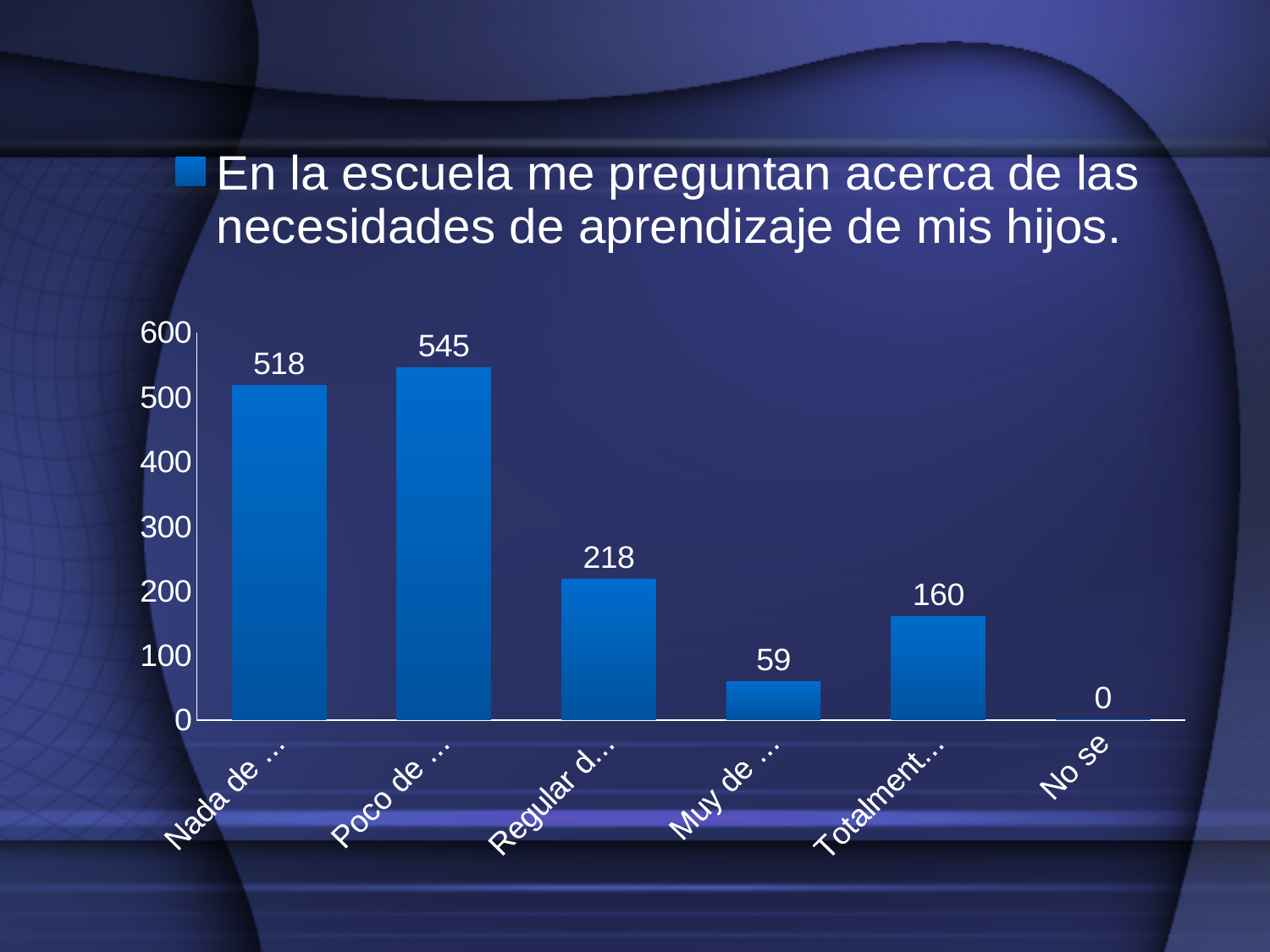
What is the value of the second bar (labelled "Poco de …")? 545 What is the value of the bar labelled "No se"? 0 Which bar has the lowest value? No se How many bars are shown in the chart? 6 What is the value of the first bar (labelled "Nada de …")? 518 What is the difference between the second bar (545) and the first bar (518)? 27 What is the value of the fifth bar (labelled "Totalment…")? 160 What is the value of the fourth bar (labelled "Muy de …")? 59 Which bar has the highest value? The second bar (Poco de …) What is the difference between the third bar (Regular d…) and the fifth bar (Totalment…)? 58 What type of chart is shown on the slide? Bar chart Which is larger, the third bar (Regular d…) or the fifth bar (Totalment…)? The third bar (Regular d…)